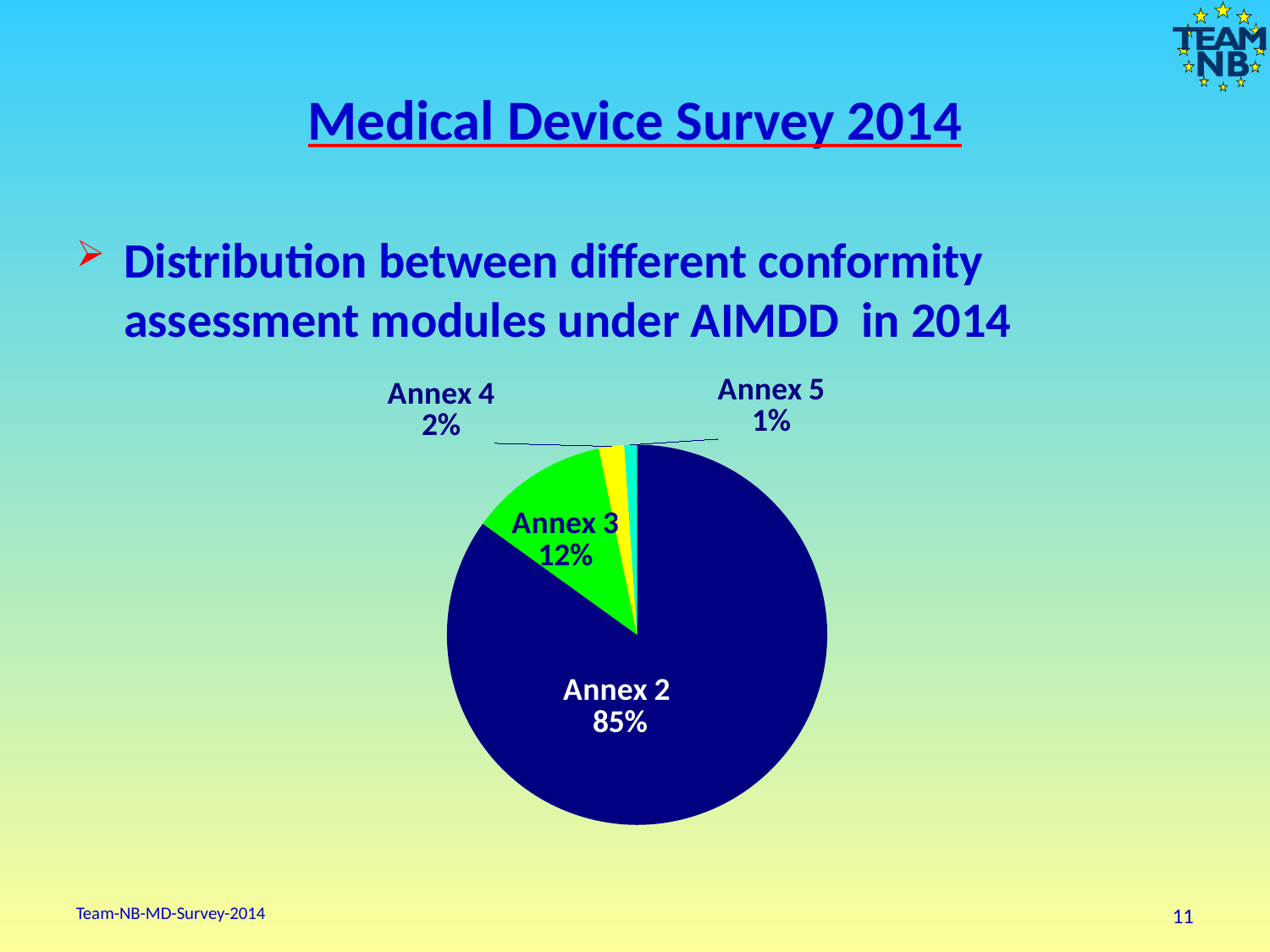
What is the value shown for Annex 5? 1% Which annex has the largest share of the pie? Annex 2 What colour is the Annex 3 slice? Green What kind of chart is shown on the slide? Pie chart What is the value shown for Annex 4? 2% What is the combined share of Annex 4 and Annex 5? 3% Which is larger, the share for Annex 3 or the share for Annex 4? Annex 3 Which annex has the smallest share of the pie? Annex 5 What is the value shown for Annex 3? 12% What is the difference in percentage points between Annex 2 and Annex 3? 73 What share of the pie does Annex 2 represent? 85% How many slices does the pie chart have? 4